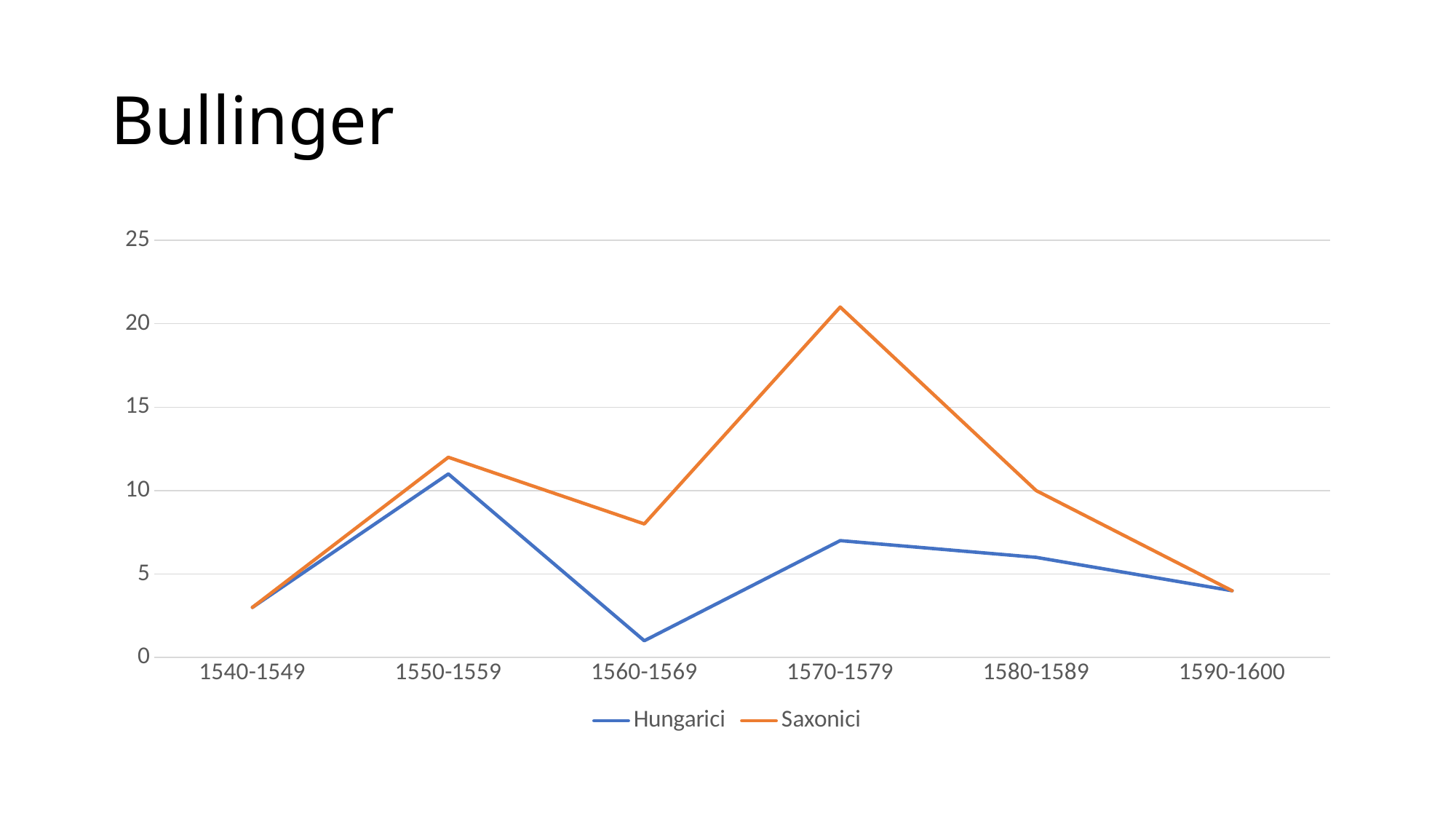
Does the Saxonici series rise or fall from 1570-1579 to 1590-1600? fall How many time periods are shown on the x axis? 6 In which period does the Saxonici series reach its highest value? 1570-1579 In which period does the Hungarici series reach its lowest value? 1560-1569 Is the value for Hungarici in 1550-1559 greater or less than 10? greater Is the value for Hungarici in 1560-1569 greater or less than 5? less In which period does the Hungarici series reach its highest value? 1550-1559 What kind of chart is shown on the slide? line chart Which series has the larger value in 1570-1579, Hungarici or Saxonici? Saxonici How many series does the legend list? 2